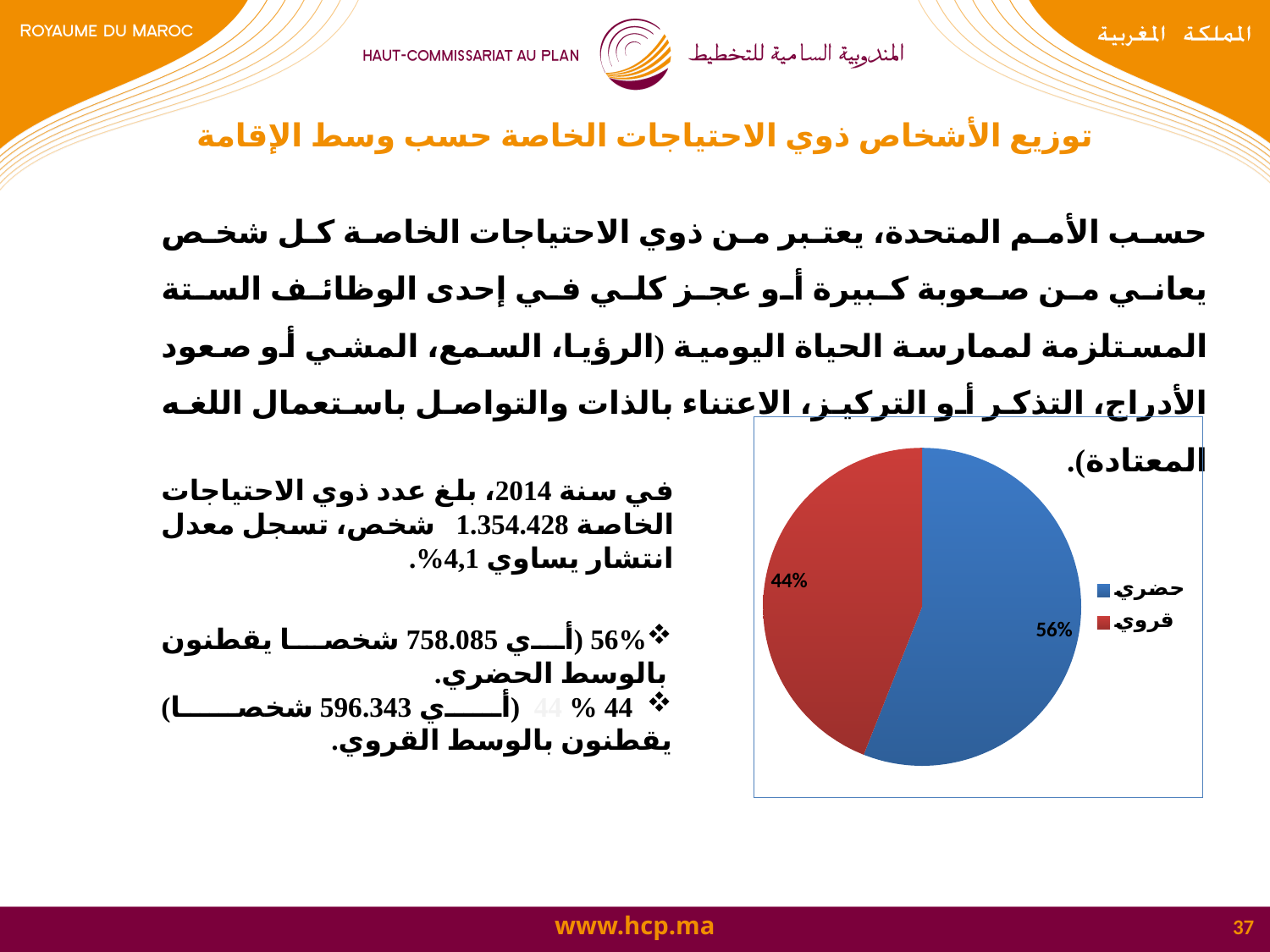
Is the share for قروي greater or less than 50%? less What is the difference in percentage points between the حضري and قروي slices? 12 What share of the pie does the حضري slice represent? 56% What share of the pie does the قروي slice represent? 44% What colour is the حضري slice in the pie chart? blue How many slices does the pie chart have? 2 Which slice is larger, حضري or قروي? حضري Which category has the largest slice of the pie? حضري What kind of chart is shown on the slide? pie chart How many entries does the legend list? 2 What colour is the قروي slice in the pie chart? red Which category has the smallest slice of the pie? قروي